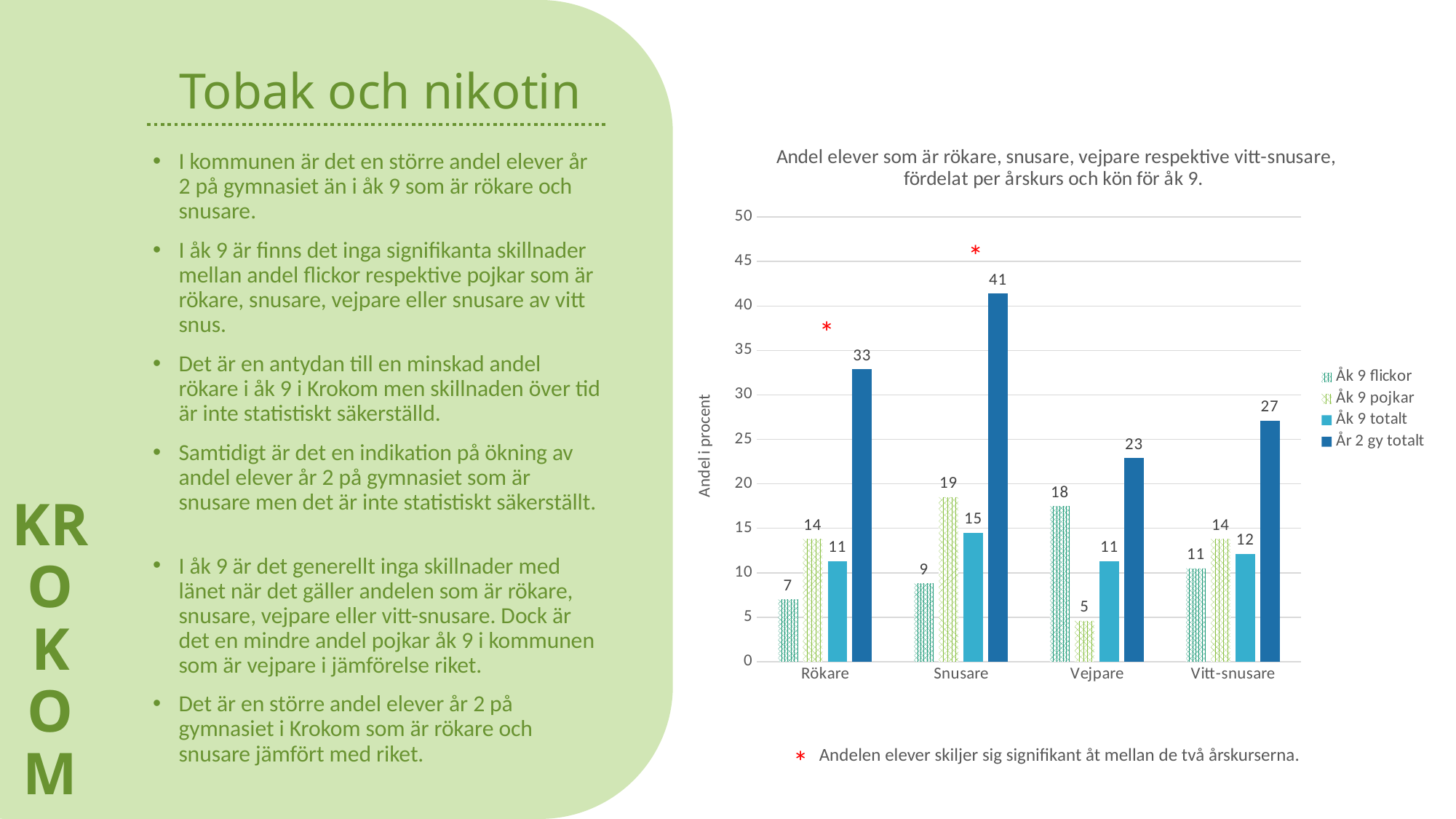
What is the value for Åk 9 flickor in the Rökare category? 7 What is the difference between År 2 gy totalt and Åk 9 totalt in the Rökare category? 22 Which is larger in the Vejpare category: Åk 9 flickor or Åk 9 pojkar? Åk 9 flickor Which category has the highest value for År 2 gy totalt? Snusare What is the value for Åk 9 pojkar in the Vejpare category? 5 What is the label of the y axis? Andel i procent What is the value for Åk 9 totalt in the Vitt-snusare category? 12 How many categories are shown on the x axis? 4 What is the value for År 2 gy totalt in the Snusare category? 41 How many series does the legend list? 4 Which category has the lowest value for Åk 9 flickor? Rökare What kind of chart is shown on the slide? Bar chart